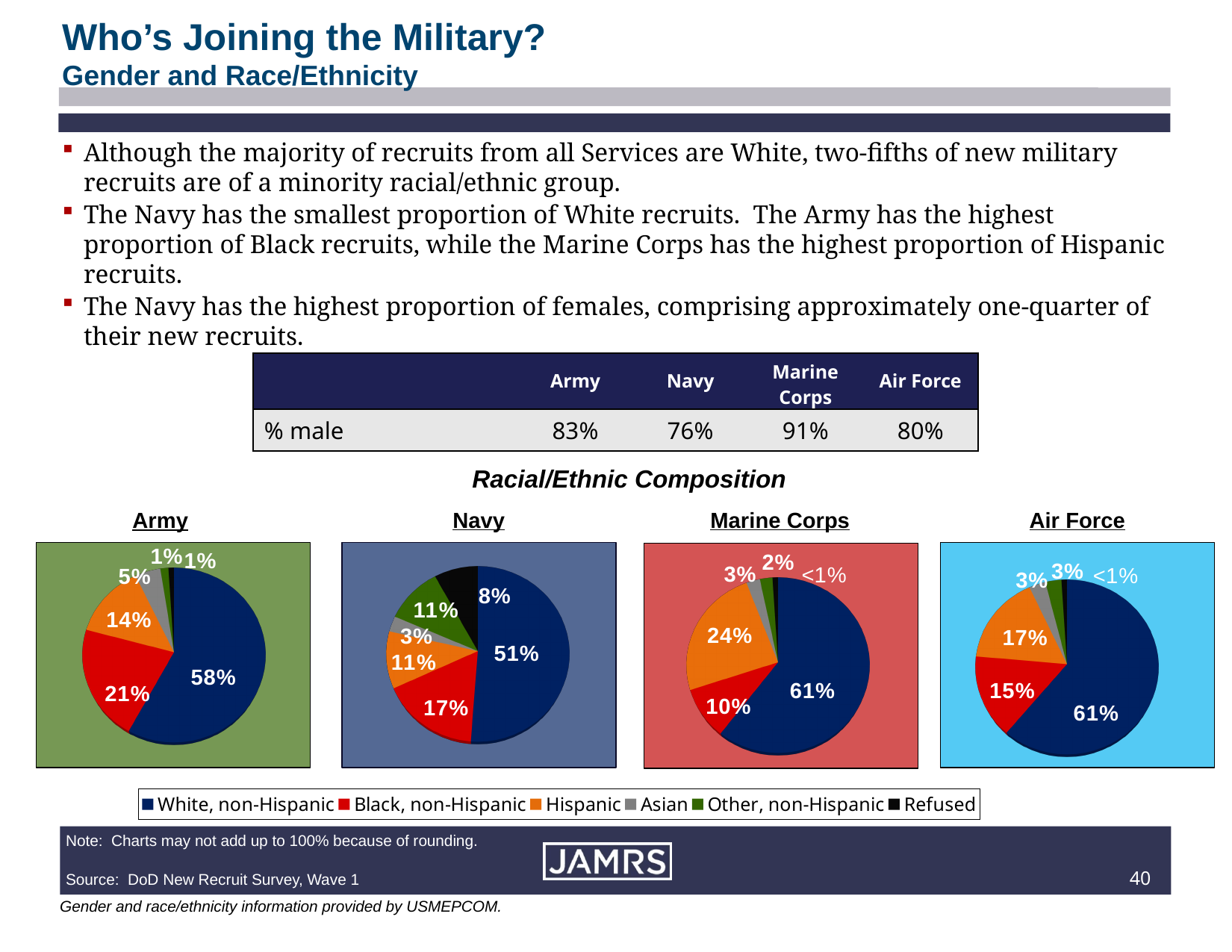
Which is larger: the Hispanic share in the Army pie chart or in the Air Force pie chart? Air Force How many racial/ethnic groups does the legend below the pie charts list? 6 What is the difference between the Black, non-Hispanic share in the Army pie chart and in the Marine Corps pie chart? 11% In the Navy pie chart, what share of recruits is Black, non-Hispanic? 17% What kind of chart is used to show the Racial/Ethnic Composition for each Service? Pie chart In the Marine Corps pie chart, what share of recruits is Hispanic? 24% In the Army pie chart, which racial/ethnic group has the largest slice? White, non-Hispanic In the Navy pie chart, what share of recruits is labelled Refused? 8% In the pie charts, which colour represents Hispanic recruits? Orange In the Army pie chart, what share of recruits is White, non-Hispanic? 58% In the Marine Corps pie chart, which racial/ethnic group has the smallest slice? Refused In the Air Force pie chart, what share of recruits is Black, non-Hispanic? 15%